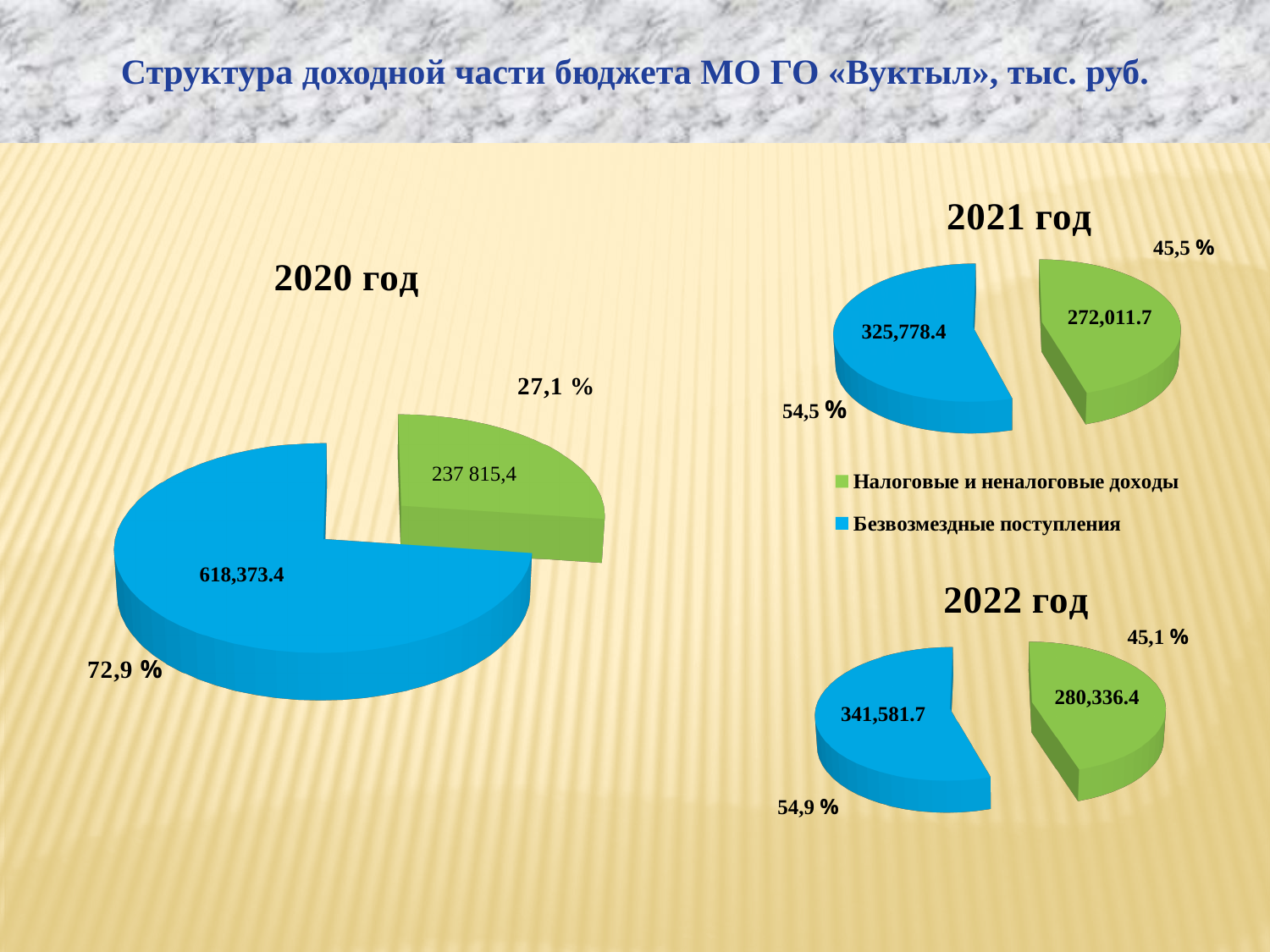
Which colour represents Налоговые и неналоговые доходы in the charts? green In the 2020 год chart, what value is shown for Безвозмездные поступления (blue slice)? 618,373.4 In the 2021 год chart, what share of the pie is Налоговые и неналоговые доходы? 45,5 % How many series does the legend list? 2 What type of chart is used for the 2020 год data? pie chart In the 2022 год chart, what value is shown for Безвозмездные поступления? 341,581.7 In the 2020 год chart, what share of the pie is Безвозмездные поступления? 72,9 % In the 2022 год chart, what is the difference between Безвозмездные поступления and Налоговые и неналоговые доходы? 61,245.3 In the 2021 год chart, which slice is larger: Налоговые и неналоговые доходы or Безвозмездные поступления? Безвозмездные поступления In the 2021 год chart, what value is shown for Налоговые и неналоговые доходы? 272,011.7 In the 2022 год chart, what share of the pie is Безвозмездные поступления? 54,9 % In the 2020 год chart, what value is shown for Налоговые и неналоговые доходы (green slice)? 237 815,4